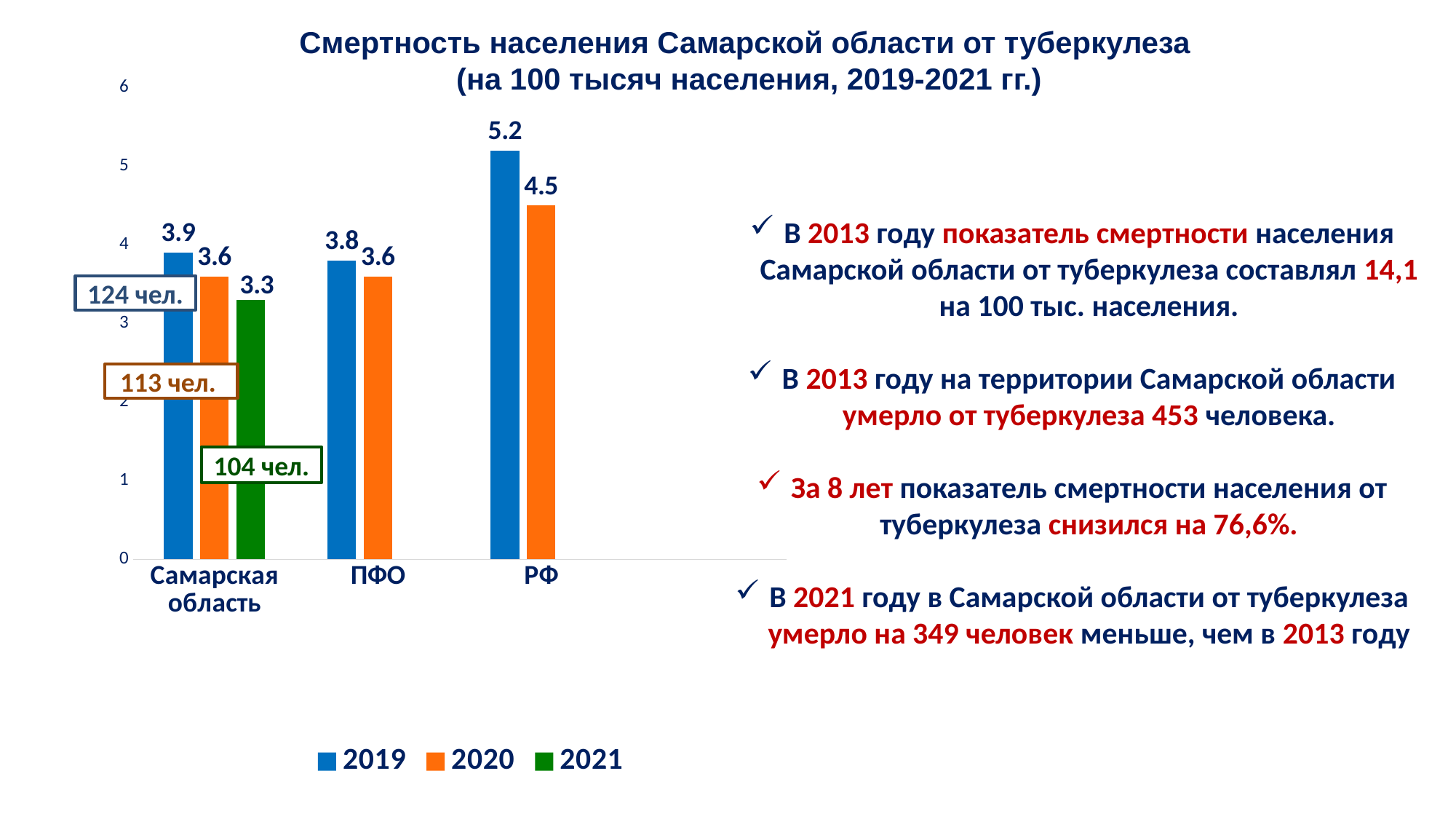
How many series does the legend list? 3 What kind of chart is shown? Bar chart Which category has the lowest 2020 value? Самарская область and ПФО (both 3.6) How many categories are shown on the x axis? 3 Which category has the highest 2019 value? РФ What is the 2020 value for РФ? 4.5 What is the 2019 value for ПФО? 3.8 What is the 2021 value for Самарская область? 3.3 What is the difference between the 2019 and 2020 values for РФ? 0.7 Which is larger: the 2019 value for Самарская область or the 2019 value for ПФО? Самарская область Which series is shown in green in the legend? 2021 What is the 2019 value for Самарская область? 3.9